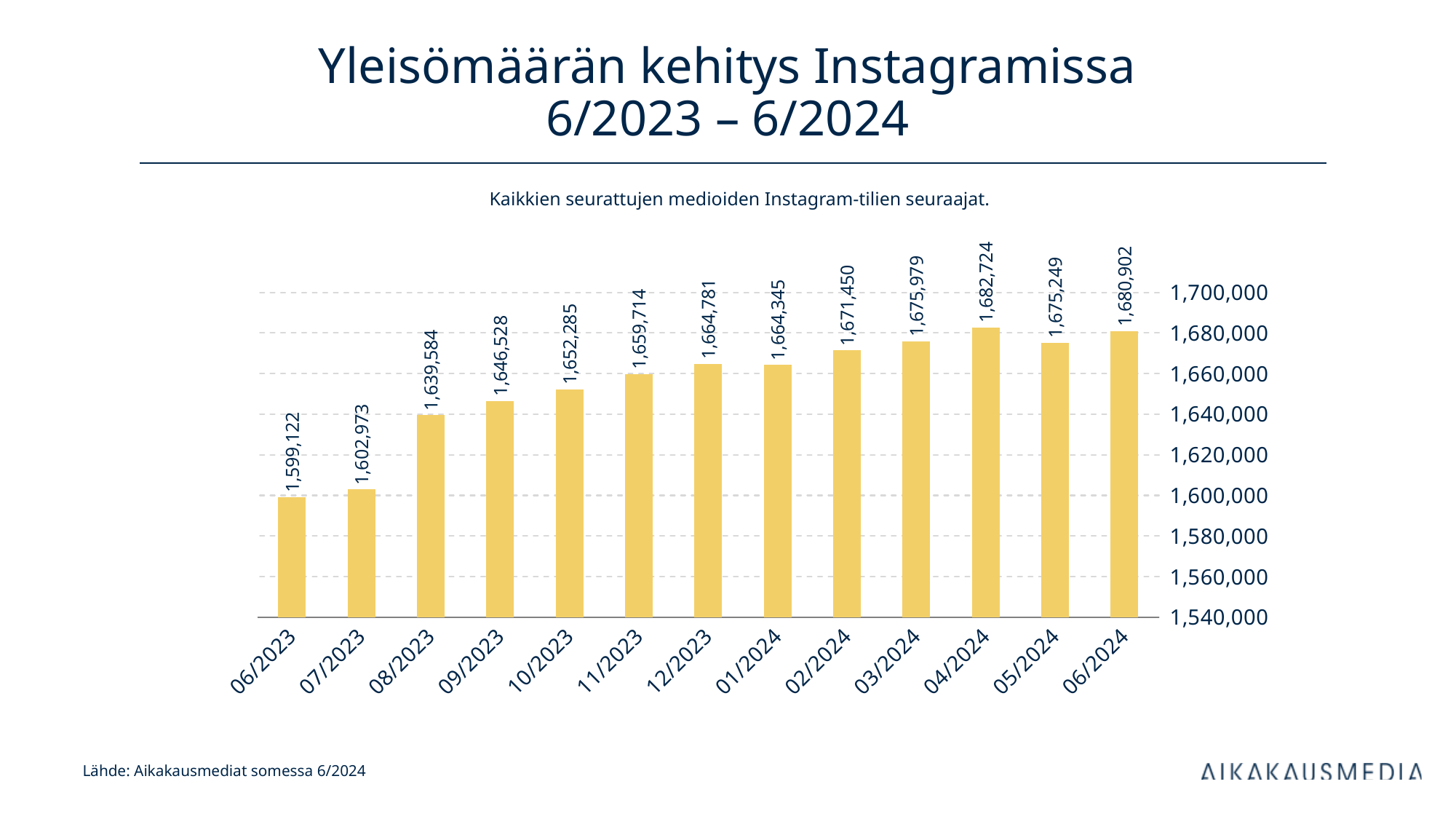
Is the value for 07/2023 greater or less than 1,620,000? less What is the value for 04/2024? 1,682,724 What is the difference between the values for 06/2024 and 06/2023? 81,780 Which is larger, the value for 08/2023 or the value for 10/2023? 10/2023 How many months are shown on the x axis? 13 What is the value for 11/2023? 1,659,714 What kind of chart is shown on the slide? bar chart What is the difference between the values for 04/2024 and 05/2024? 7,475 Which month has the highest value? 04/2024 Which month has the lowest value? 06/2023 Do the values generally rise or fall from 06/2023 to 06/2024? rise What is the value for 06/2023? 1,599,122